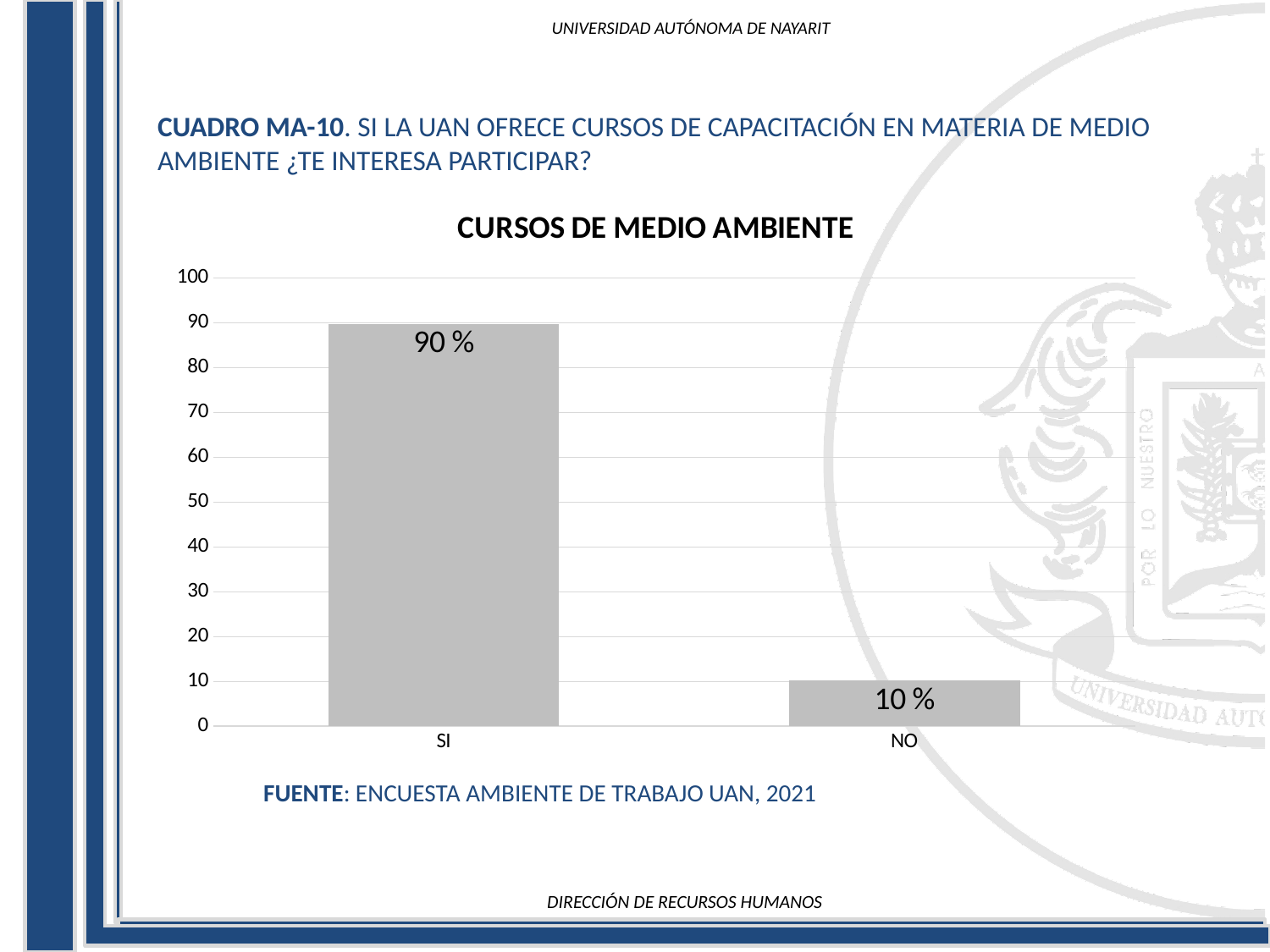
What is the difference between the values for SI and NO? 80 % What is the maximum value shown on the y axis? 100 Which category has the highest value? SI What kind of chart is shown? bar chart How many categories are shown on the x axis? 2 Is the value for SI greater or less than 50? greater What is the title of the chart? CURSOS DE MEDIO AMBIENTE Which category has the lowest value? NO What is the value for SI? 90 % Which is larger, the value for SI or the value for NO? SI What is the value for NO? 10 % Is the value for NO greater or less than 20? less